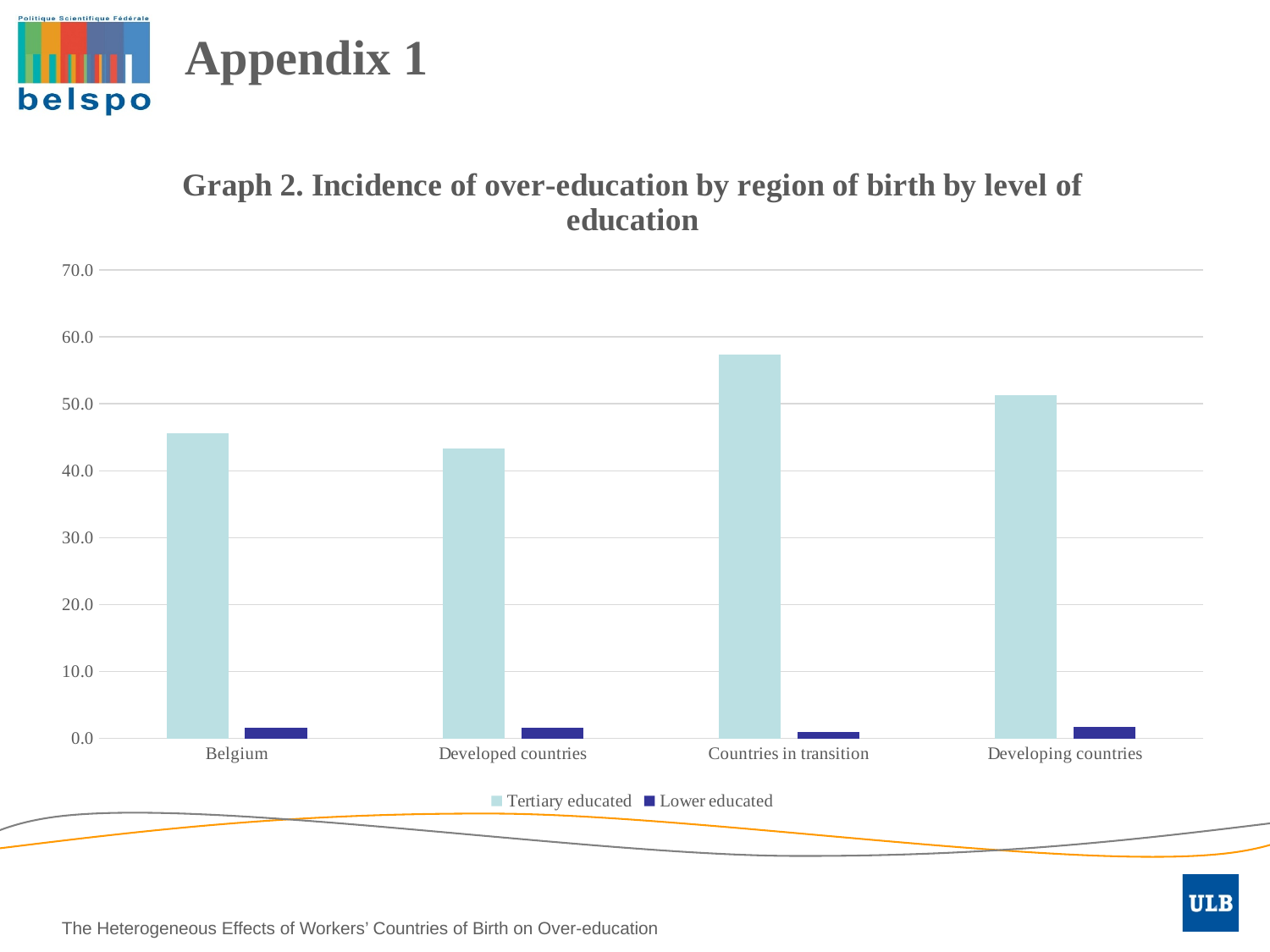
Is the Tertiary educated value for Belgium greater or less than 50.0? less Is the Tertiary educated value for Countries in transition greater or less than 50.0? greater How many regions of birth are shown on the x axis? 4 Which region of birth has the highest value for Tertiary educated? Countries in transition How many series does the legend list? 2 Which series is shown in dark blue in the legend? Lower educated What kind of chart is shown on the slide? bar chart Is the Lower educated value for Developing countries greater or less than 10.0? less Which region of birth has the lowest value for Tertiary educated? Developed countries What is the title of the chart? Graph 2. Incidence of over-education by region of birth by level of education Which is larger for Tertiary educated: Belgium or Developed countries? Belgium Which is larger for Tertiary educated: Countries in transition or Developing countries? Countries in transition